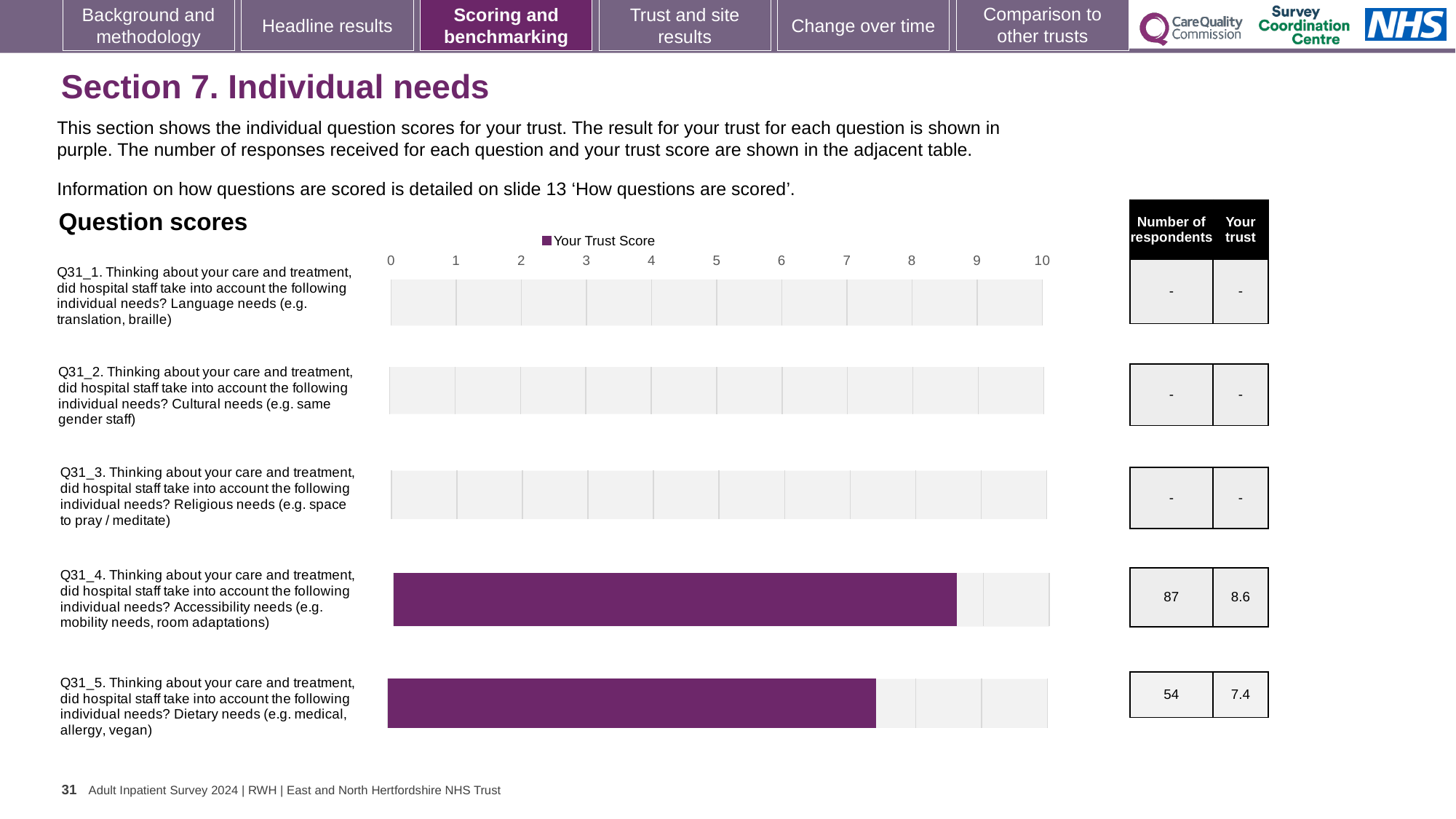
What is the difference between the trust scores for Q31_4 and Q31_5? 1.2 What is the legend entry shown above the chart? Your Trust Score What type of chart is shown on the slide? Bar chart How many questions are listed on the chart? 5 What is the trust score for Q31_5 (Dietary needs)? 7.4 What is the trust score for Q31_4 (Accessibility needs)? 8.6 Is the trust score for Q31_5 (Dietary needs) greater or less than 8? less Is the trust score for Q31_4 (Accessibility needs) greater or less than 8? greater How many respondents answered Q31_5 (Dietary needs)? 54 Which question has the highest trust score shown on the chart? Q31_4 (Accessibility needs) Which has a larger trust score, Q31_4 (Accessibility needs) or Q31_5 (Dietary needs)? Q31_4 (Accessibility needs) How many respondents answered Q31_4 (Accessibility needs)? 87